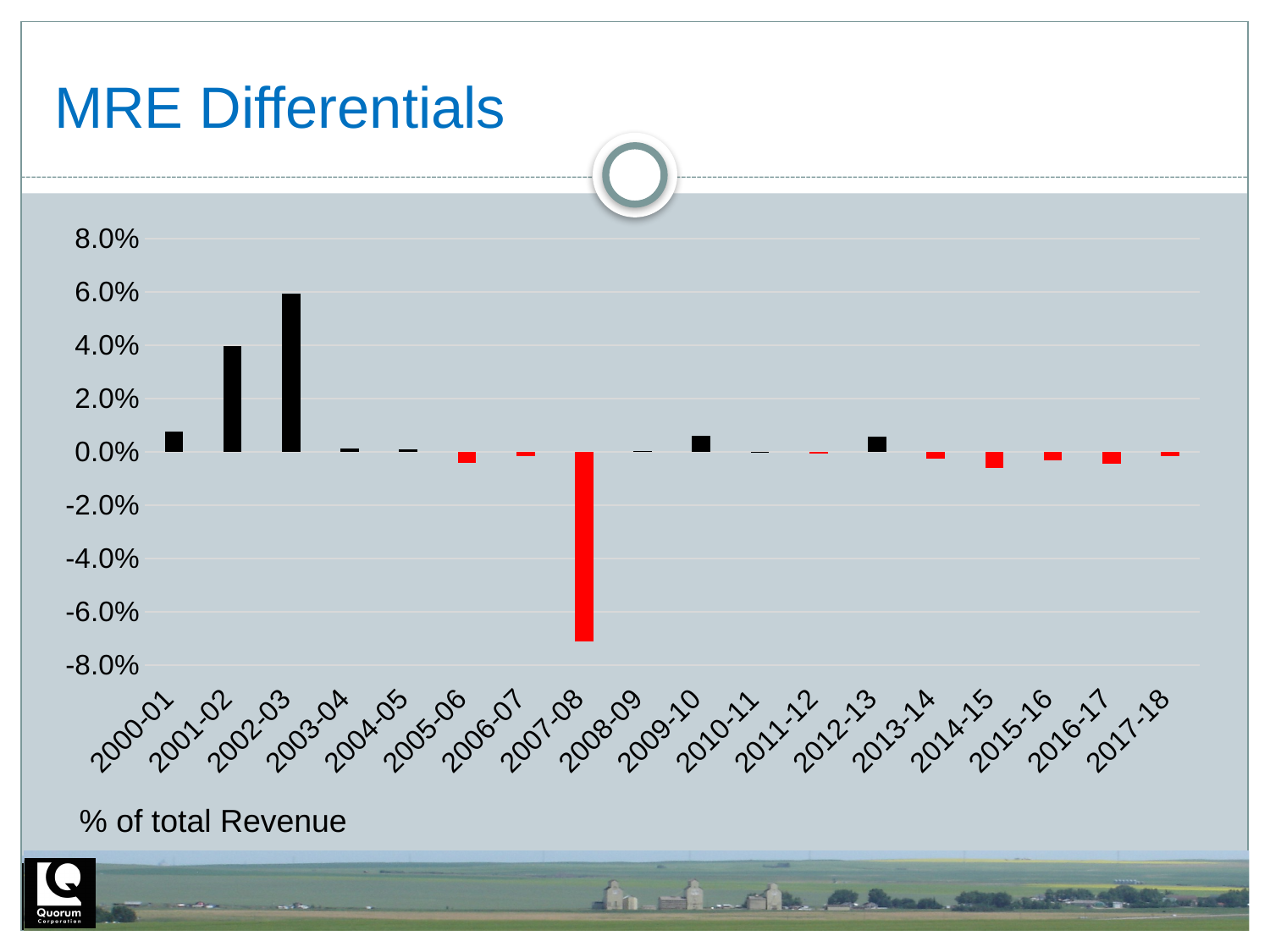
How many fiscal-year categories are plotted on the x axis? 18 What kind of chart is shown on the slide? bar chart Is the value for 2001-02 greater or less than 2.0%? greater Is the value for 2007-08 greater or less than -6.0%? less Which year has the highest MRE differential? 2002-03 Which is larger, the value for 2009-10 or the value for 2007-08? 2009-10 What unit label is shown below the chart? % of total Revenue What is the title of the slide containing the chart? MRE Differentials Which is larger, the value for 2001-02 or the value for 2002-03? 2002-03 Which year has the lowest MRE differential? 2007-08 Is the value for 2000-01 greater or less than 2.0%? less